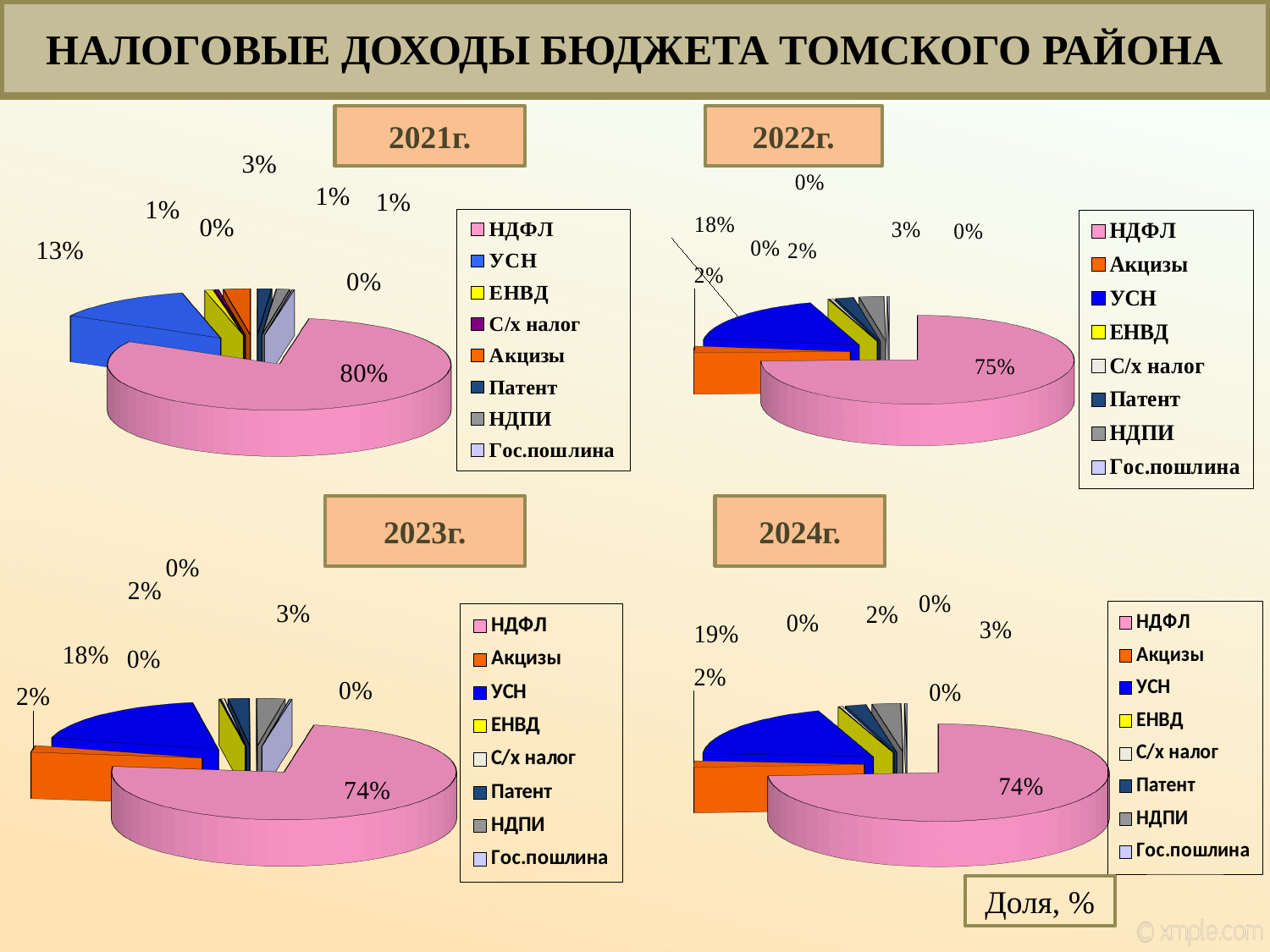
In the 2021г. pie chart, what share does НДФЛ have? 80% In the 2024г. pie chart, what share does НДФЛ have? 74% In the 2023г. pie chart, what share does НДФЛ have? 74% In the 2021г. pie chart, what share does УСН have? 13% What is the difference between the НДФЛ share in the 2021г. chart and in the 2022г. chart? 5 percentage points In the 2022г. pie chart, which category has the largest slice? НДФЛ In the 2022г. pie chart, what share does НДФЛ have? 75% In the 2023г. pie chart, which category has the second largest slice? УСН What type of chart is used for the 2024г. data? Pie chart Is the НДФЛ share larger in the 2021г. chart or in the 2024г. chart? 2021г. How many entries does the legend of the 2023г. chart list? 8 In the 2024г. pie chart, what share does УСН have? 19%